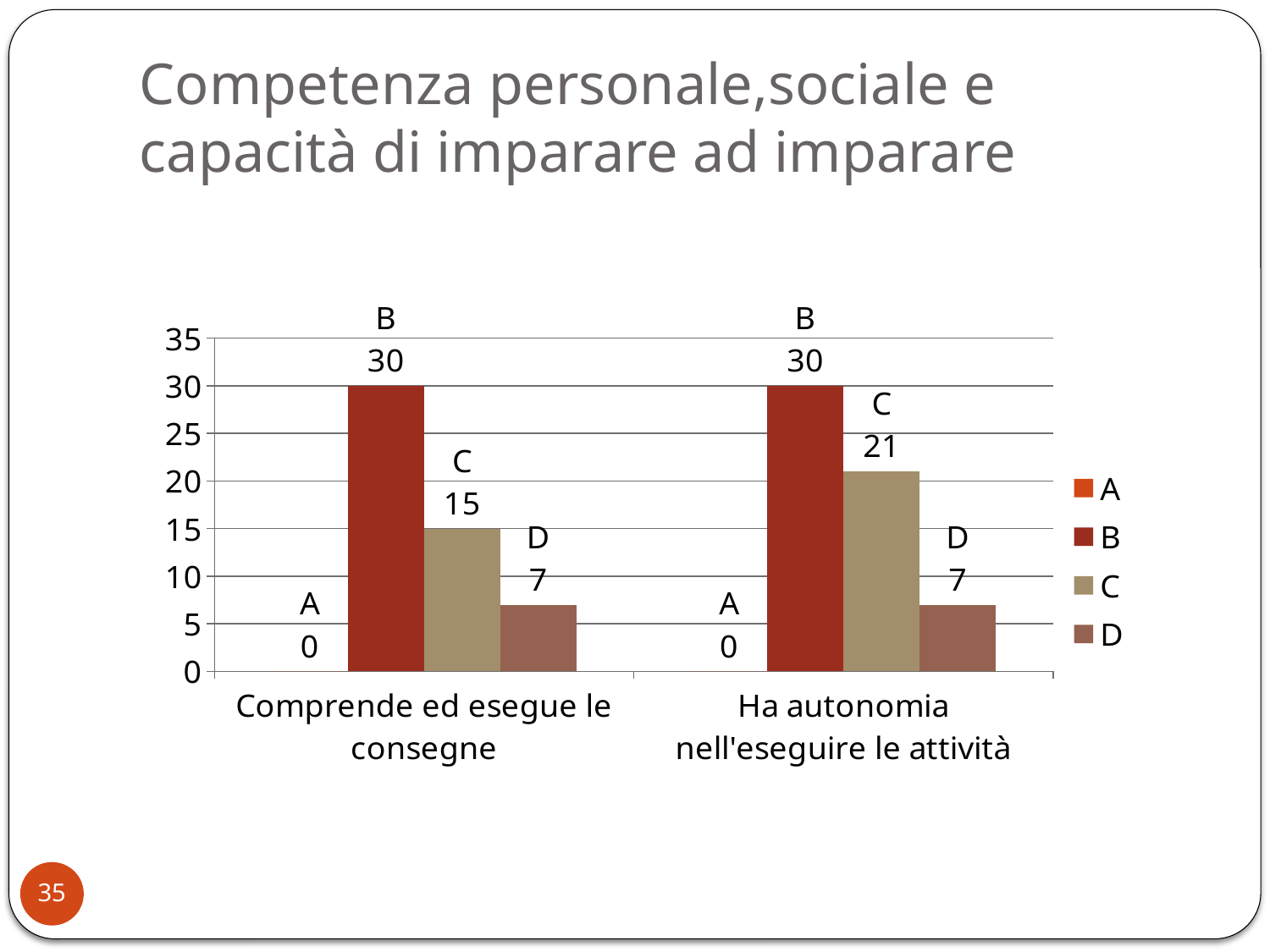
What kind of chart is shown on the slide? Bar chart Which is larger: series C for "Comprende ed esegue le consegne" or series C for "Ha autonomia nell'eseguire le attività"? Ha autonomia nell'eseguire le attività What is the value of series D for "Comprende ed esegue le consegne"? 7 What is the difference between the values of series C for "Ha autonomia nell'eseguire le attività" and "Comprende ed esegue le consegne"? 6 How many categories are shown on the x axis? 2 Which series has the highest value for "Ha autonomia nell'eseguire le attività"? B What is the value of series B for "Comprende ed esegue le consegne"? 30 What is the difference between series B and series C for "Comprende ed esegue le consegne"? 15 What is the value of series C for "Ha autonomia nell'eseguire le attività"? 21 Which series has the lowest value for "Comprende ed esegue le consegne"? A What is the value of series A for "Ha autonomia nell'eseguire le attività"? 0 How many series does the legend list? 4